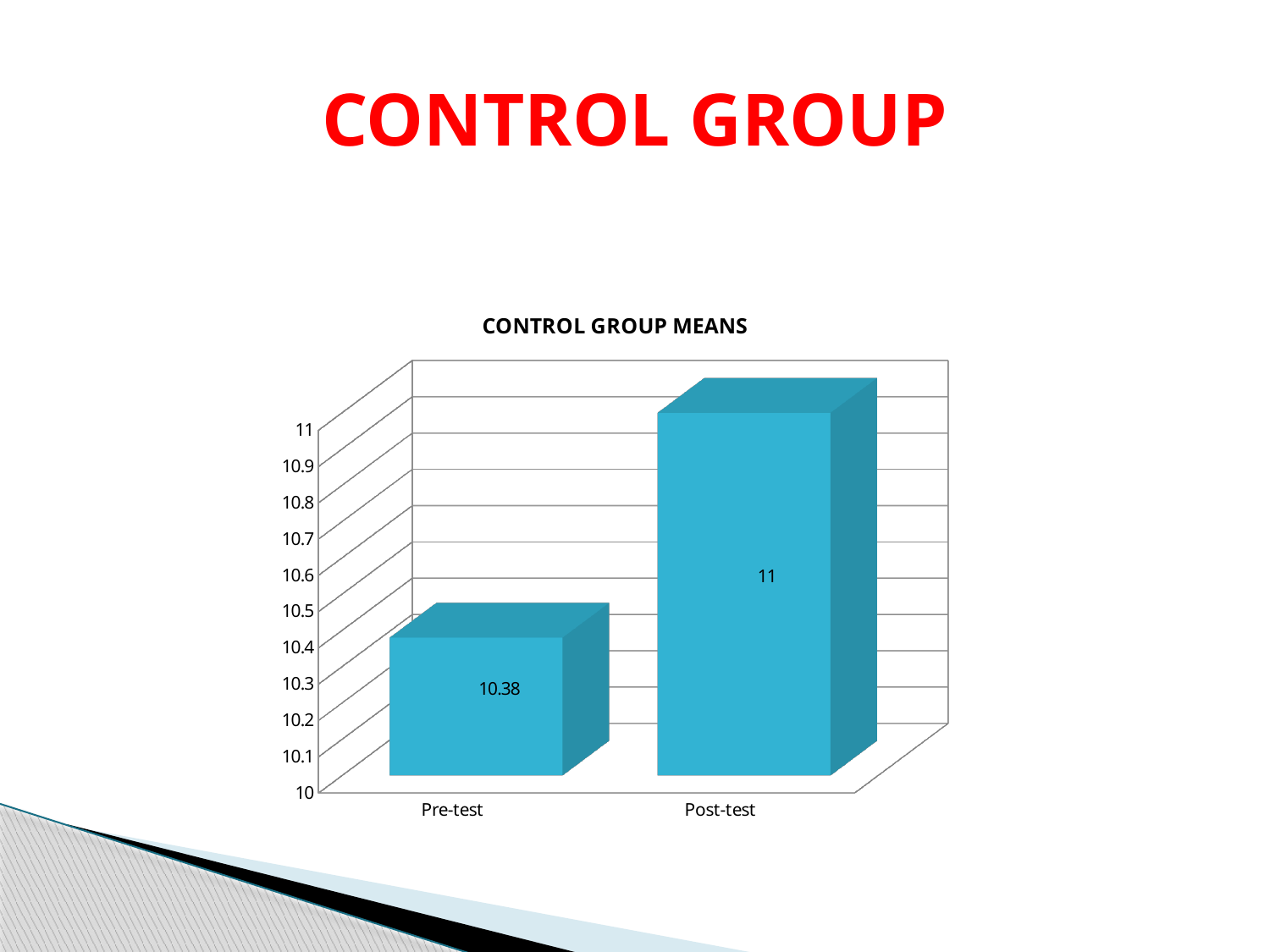
Do the values rise or fall from Pre-test to Post-test? rise Which is larger, the Pre-test value or the Post-test value? Post-test Which category has the highest value? Post-test What is the title of the chart? CONTROL GROUP MEANS Which category has the lowest value? Pre-test What is the value for Post-test? 11 What kind of chart is shown? bar chart Is the value for Pre-test greater or less than 10.5? less What is the value for Pre-test? 10.38 What is the difference between the Post-test and Pre-test values? 0.62 What is the lowest value shown on the vertical axis? 10 How many categories are shown on the x axis? 2